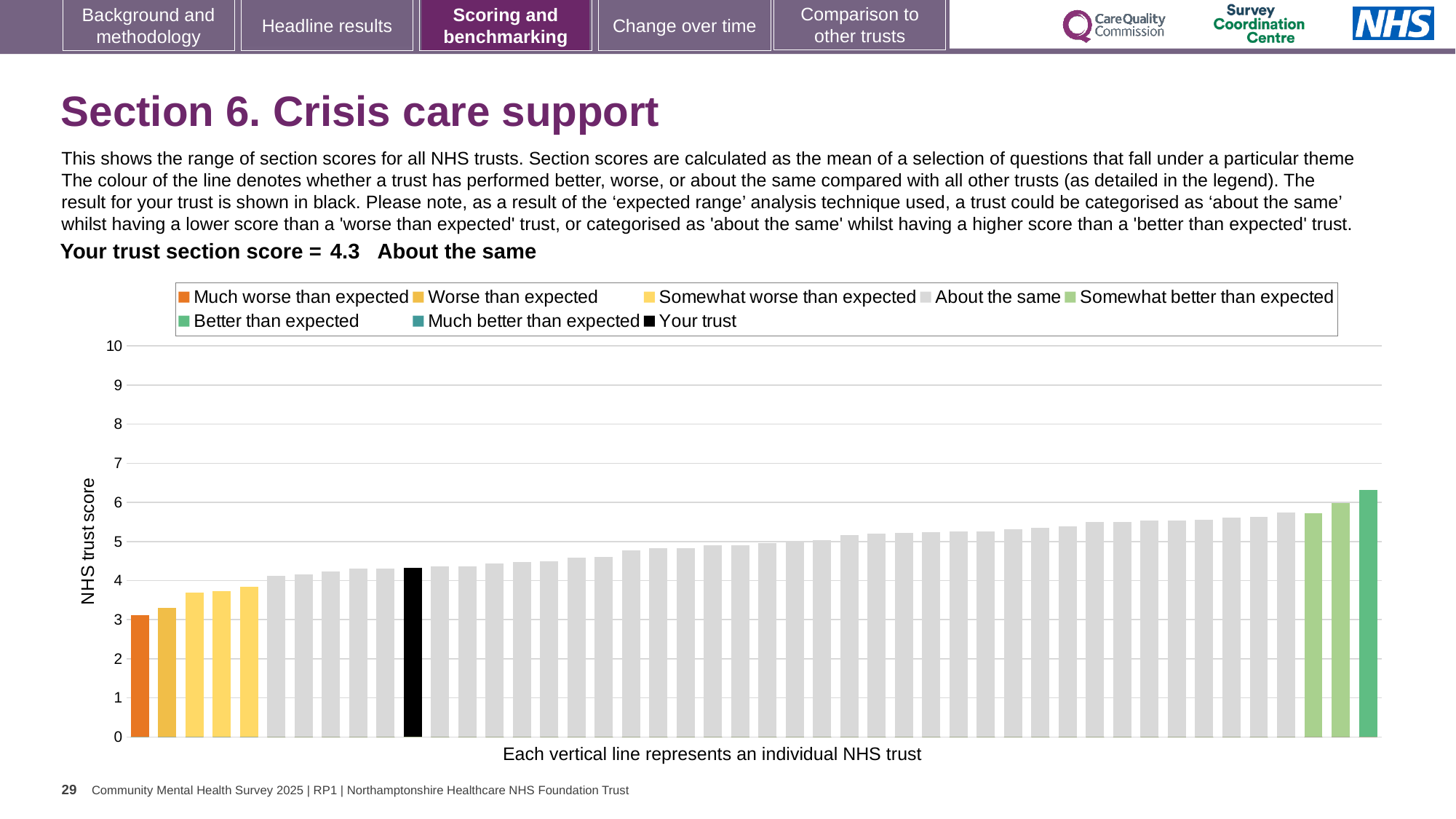
Is the value of the shortest bar greater or less than 4? less What does each vertical line in the chart represent, according to the x-axis label? An individual NHS trust Is the value of the tallest bar greater or less than 7? less What kind of chart is shown on the slide? bar chart How many entries does the chart legend list? 8 How many bars are coloured as 'Somewhat worse than expected'? 3 Is the value of the black bar (your trust) greater or less than 5? less Which category is your trust placed in for this section? About the same Do the bar values rise or fall from left to right along the x axis? rise Which legend category does the shortest bar belong to? Much worse than expected Which legend category does the tallest bar belong to? Better than expected What is the section score for your trust shown on the slide? 4.3